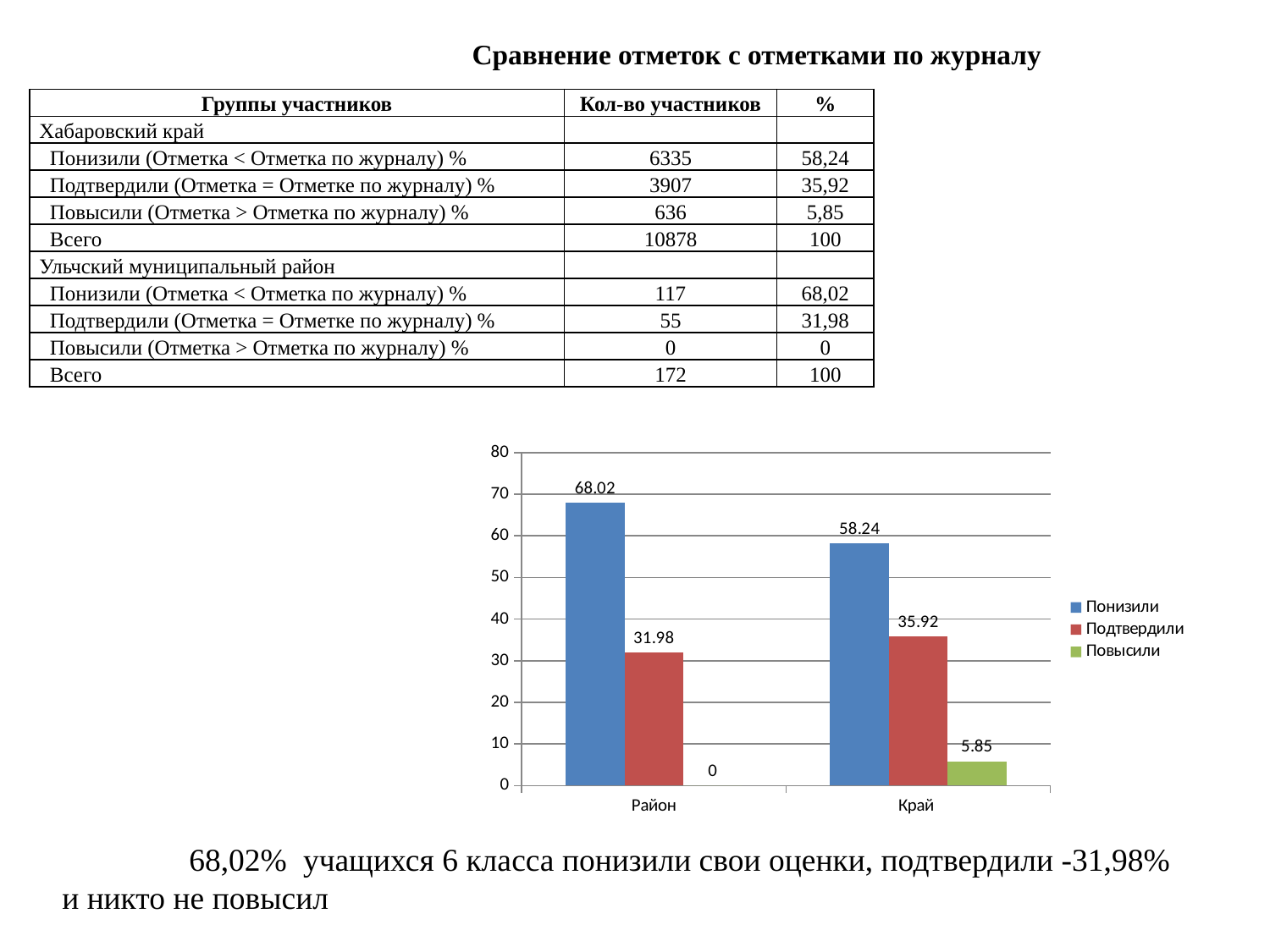
Which series has the highest value for Край in the chart? Понизили What is the value of Повысили for Край in the chart? 5.85 Which legend entry is shown in green in the chart? Повысили How many categories are shown on the x axis of the chart? 2 What is the value of Понизили for Район in the chart? 68.02 How many series does the chart legend list? 3 Which is larger in the chart: Подтвердили for Район or Подтвердили for Край? Подтвердили for Край What is the value of Повысили for Район in the chart? 0 What is the difference between the Понизили values for Район and Край in the chart? 9.78 What kind of chart is shown on the slide? bar chart Which series has the lowest value for Район in the chart? Повысили What is the value of Подтвердили for Край in the chart? 35.92